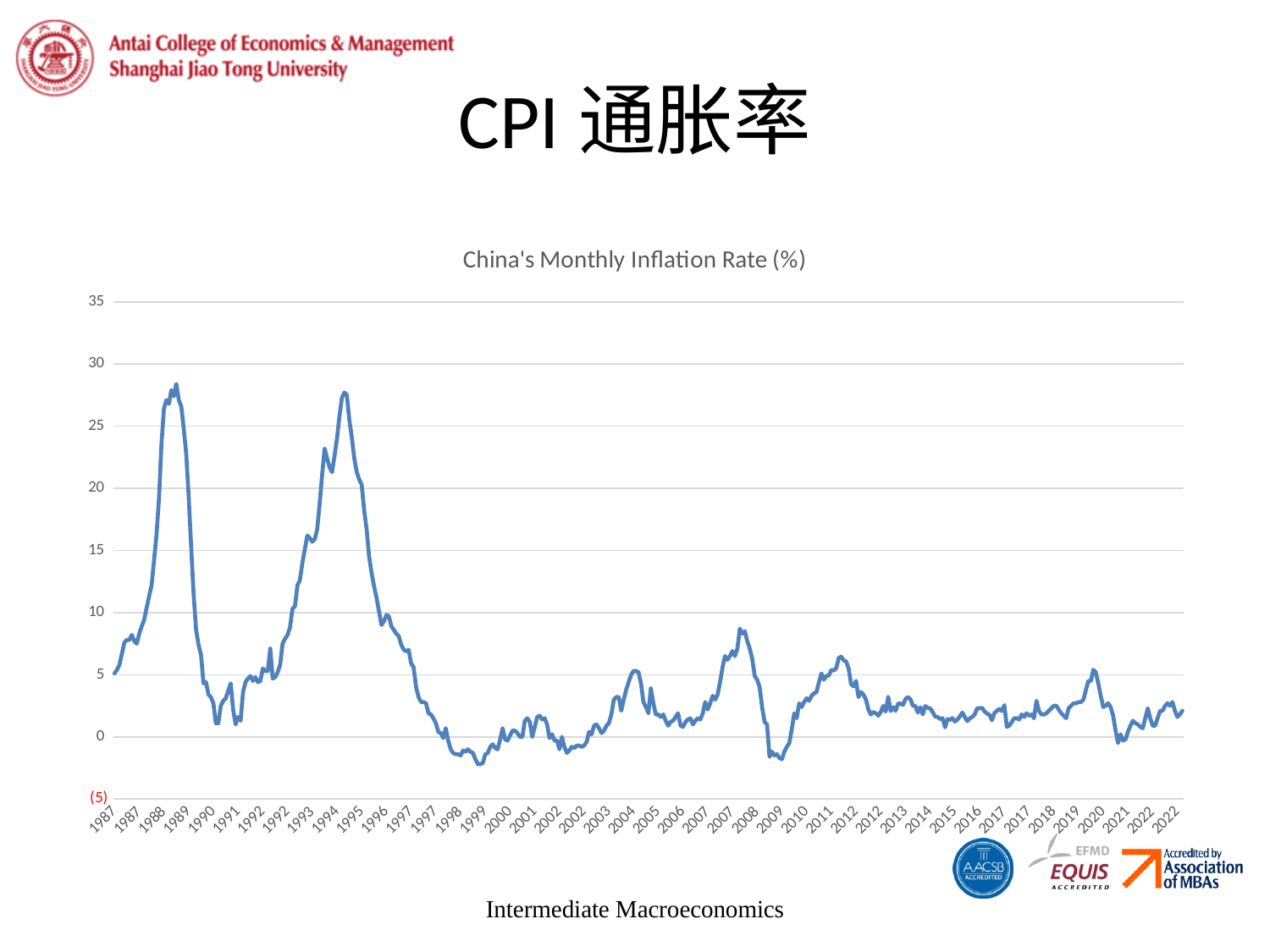
Is the inflation rate in 1999 greater or less than 0? less What kind of chart is shown on the slide? line chart Is the lowest inflation rate in 2009 greater or less than 0? less Is the inflation rate in 2016 greater or less than 5? less What is the highest value shown on the vertical axis of the chart? 35 Does the inflation rate generally rise or fall between 1994 and 1999? fall Does the inflation rate rise or fall between 1987 and 1988? rise What is the title of the chart on the slide? China's Monthly Inflation Rate (%) Is the peak inflation rate in 1988 greater or less than the peak in 2008? 1988 peak is greater